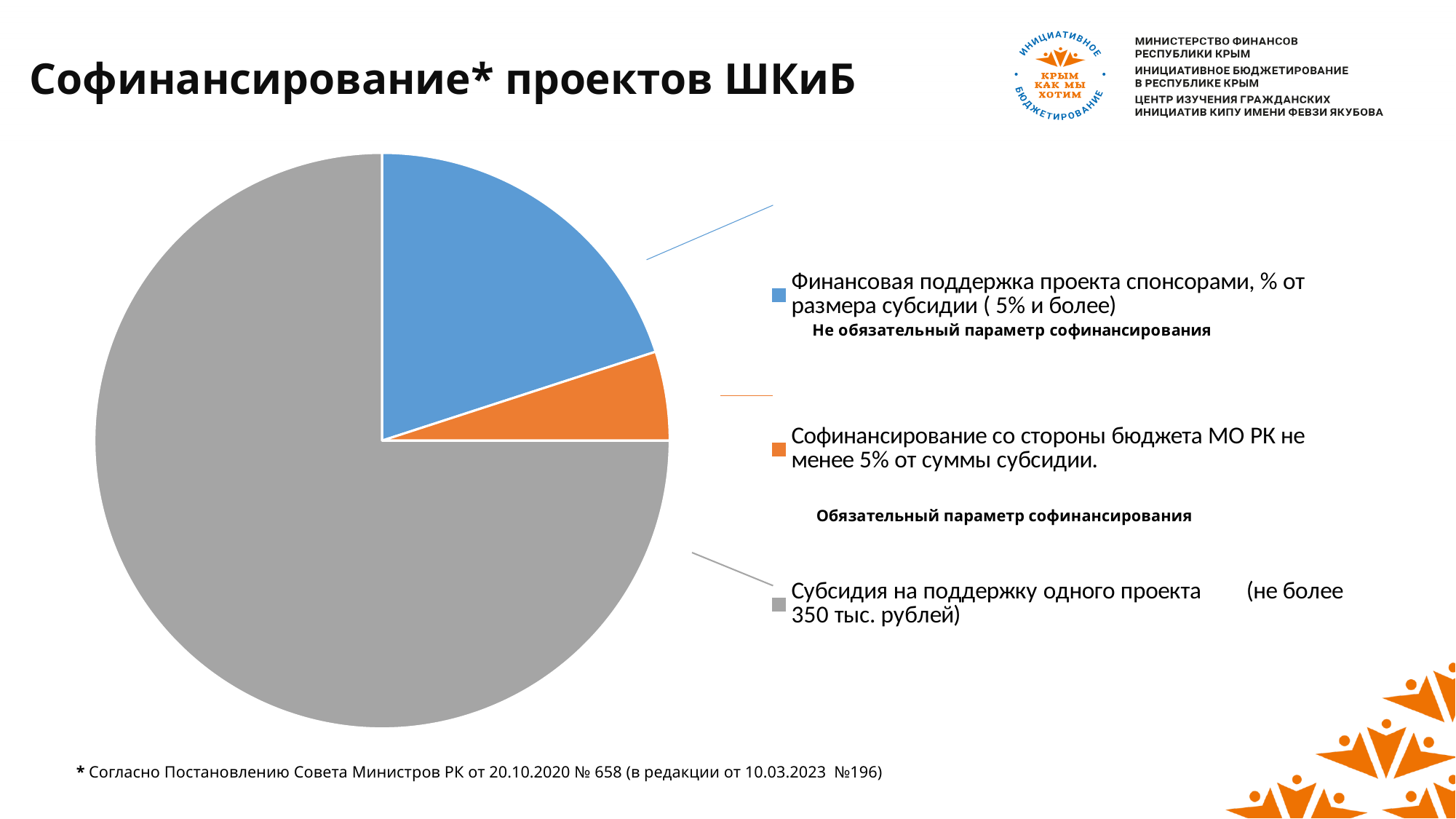
Which slice is larger: the subsidy slice or the sponsor financial support slice? Субсидия на поддержку одного проекта (не более 350 тыс. рублей) Which slice of the pie chart is the smallest? Софинансирование со стороны бюджета МО РК не менее 5% от суммы субсидии. Which slice is larger: the sponsor financial support slice or the MO RK budget co-financing slice? Финансовая поддержка проекта спонсорами, % от размера субсидии ( 5% и более) How many slices does the pie chart have? 3 What is the title of the slide containing the pie chart? Софинансирование* проектов ШКиБ What kind of chart is shown on the slide? pie chart Which slice of the pie chart is the largest? Субсидия на поддержку одного проекта (не более 350 тыс. рублей) What colour is the slice for 'Софинансирование со стороны бюджета МО РК не менее 5% от суммы субсидии.'? orange How many entries does the legend of the pie chart list? 3